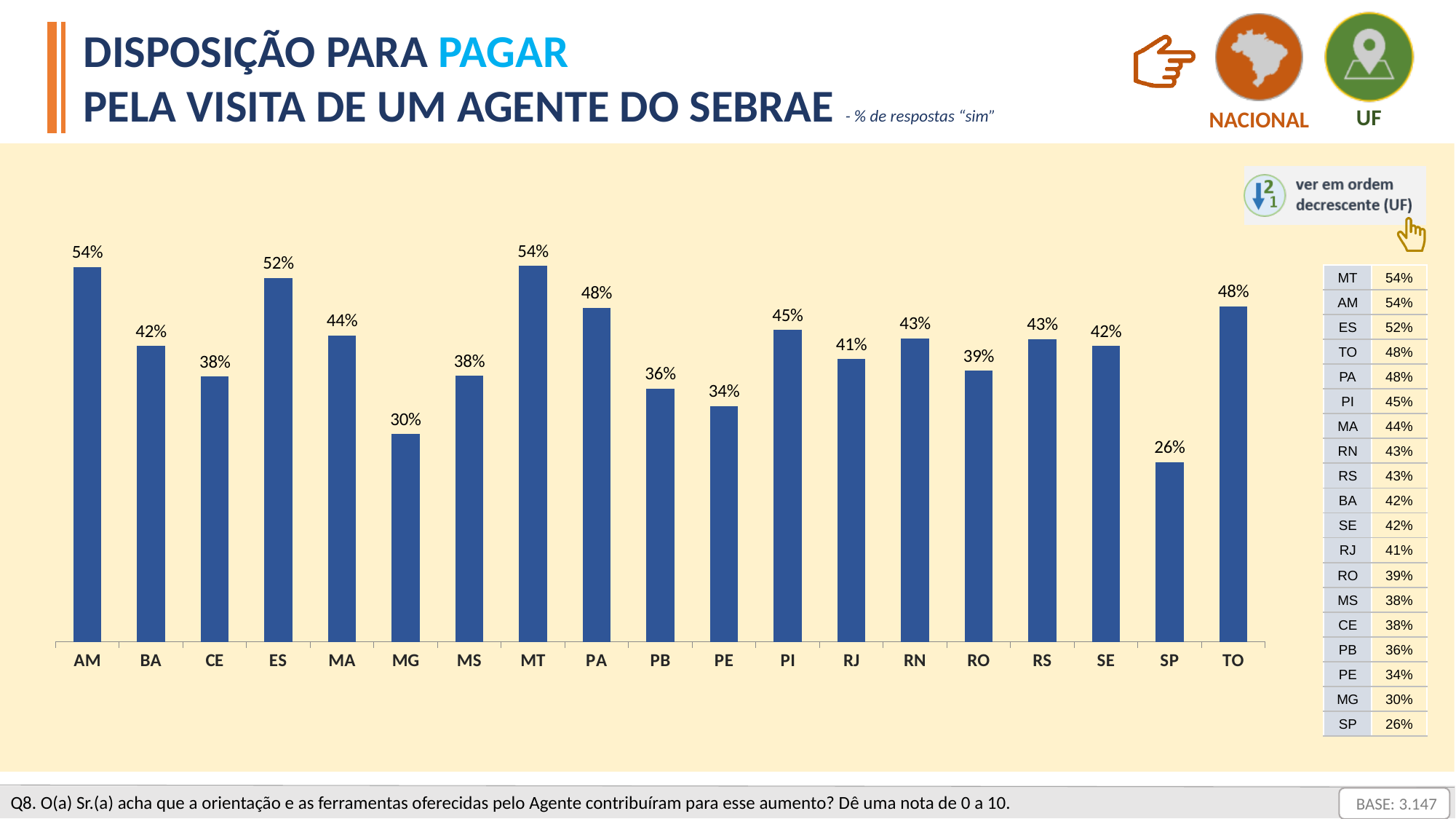
How many categories are shown on the x axis? 19 Which is larger, the value for MA or the value for RJ? MA What is the value for MG? 30% What kind of chart is shown on the slide? bar chart What is the difference between the values for MT and SP? 28% Which category has the lowest value? SP What is the value for ES? 52% Which is larger, the value for PB or the value for RN? RN What value does the table on the right list for CE? 38% What is the value for RO? 39% What is the value for PI? 45% What is the difference between the values for PA and PE? 14%